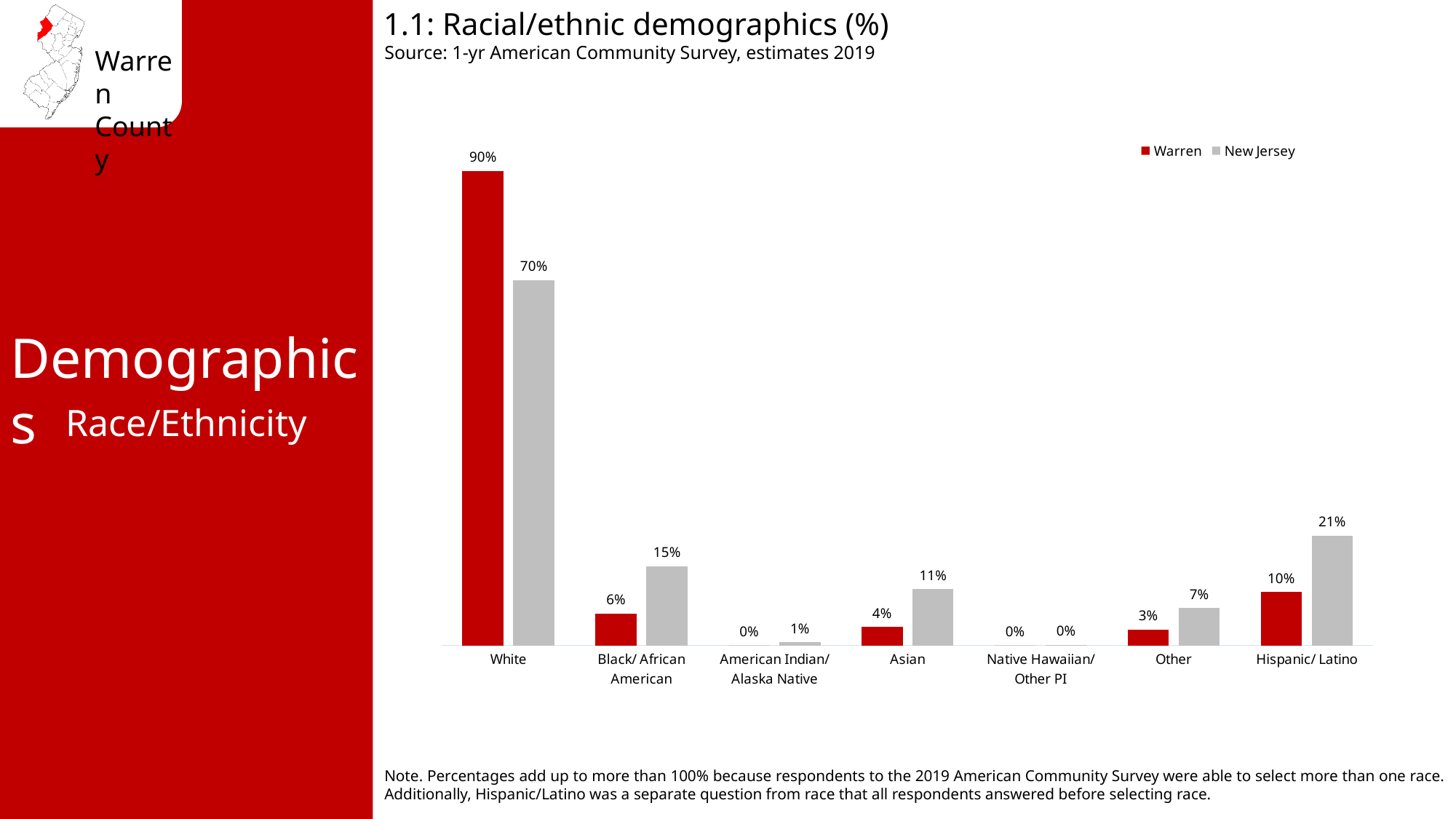
Which category has the highest New Jersey value? White What is the difference between the New Jersey and Warren values for Hispanic/ Latino? 11% How many series does the legend list? 2 What kind of chart is shown? Bar chart What is the Warren value for Asian? 4% What is the New Jersey value for Black/ African American? 15% What is the difference between the Warren and New Jersey values for White? 20% What is the Warren value for White? 90% Which category has the highest Warren value? White Which is larger for Other: the Warren value or the New Jersey value? New Jersey How many categories are shown on the x axis? 7 What is the New Jersey value for Hispanic/ Latino? 21%